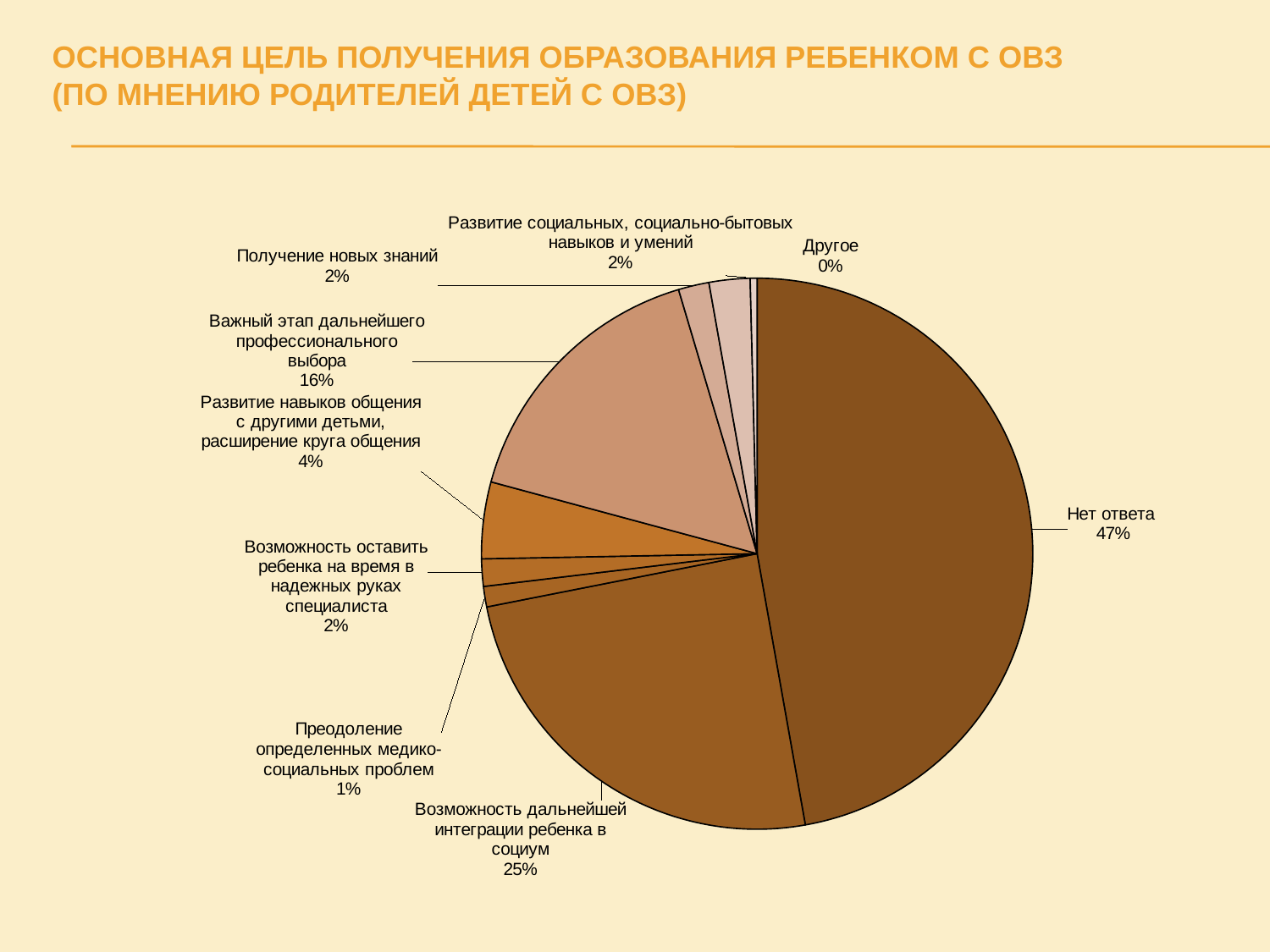
What percentage is shown for "Важный этап дальнейшего профессионального выбора"? 16% Which category has the smallest share of the pie? Другое What share of the pie is labelled "Нет ответа"? 47% What percentage is shown for "Развитие навыков общения с другими детьми, расширение круга общения"? 4% What kind of chart is shown on the slide? Pie chart Which category has the largest share of the pie? Нет ответа What percentage is shown for "Другое"? 0% How many categories are shown in the pie chart? 9 Which is larger: the share for "Важный этап дальнейшего профессионального выбора" or for "Развитие навыков общения с другими детьми, расширение круга общения"? Важный этап дальнейшего профессионального выбора What percentage is shown for "Преодоление определенных медико-социальных проблем"? 1% What is the difference in percentage points between "Нет ответа" and "Возможность дальнейшей интеграции ребенка в социум"? 22 What percentage is shown for "Возможность дальнейшей интеграции ребенка в социум"? 25%